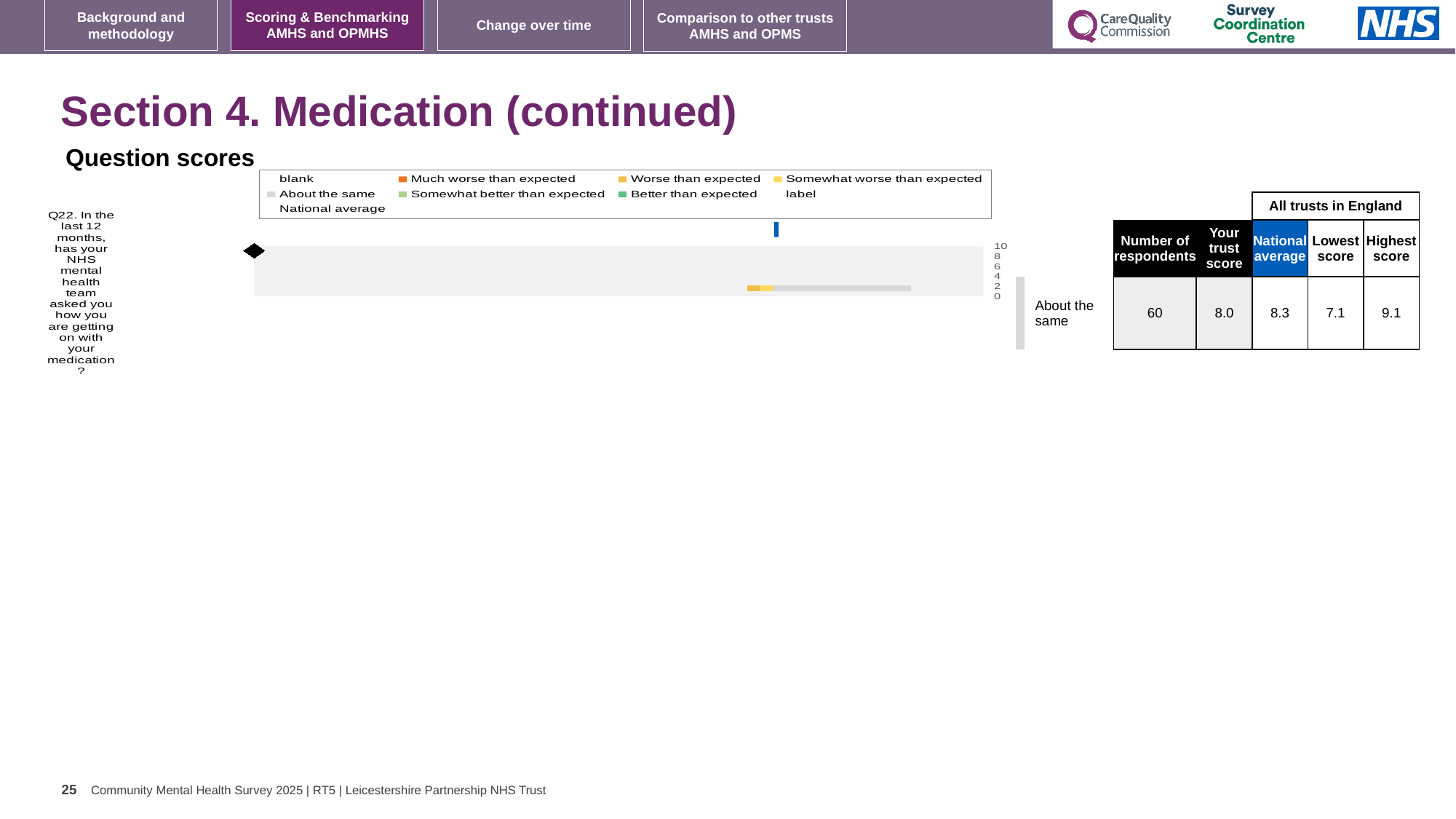
What is the trust's score for Q22? 8.0 What is the national average score for Q22? 8.3 What benchmark category is shown for Q22 in the chart? About the same What is the difference between the highest and lowest trust scores for Q22? 2.0 What is the difference between the national average and the trust's score for Q22? 0.3 What is the highest score among all trusts in England for Q22? 9.1 Which is larger for Q22, the trust's score or the national average? national average What is the lowest score among all trusts in England for Q22? 7.1 What kind of chart is shown on the slide? bar chart Which question is plotted in the chart? Q22. In the last 12 months, has your NHS mental health team asked you how you are getting on with your medication? Is the trust's score for Q22 greater or less than 6 on the chart's axis? greater How many respondents answered Q22? 60